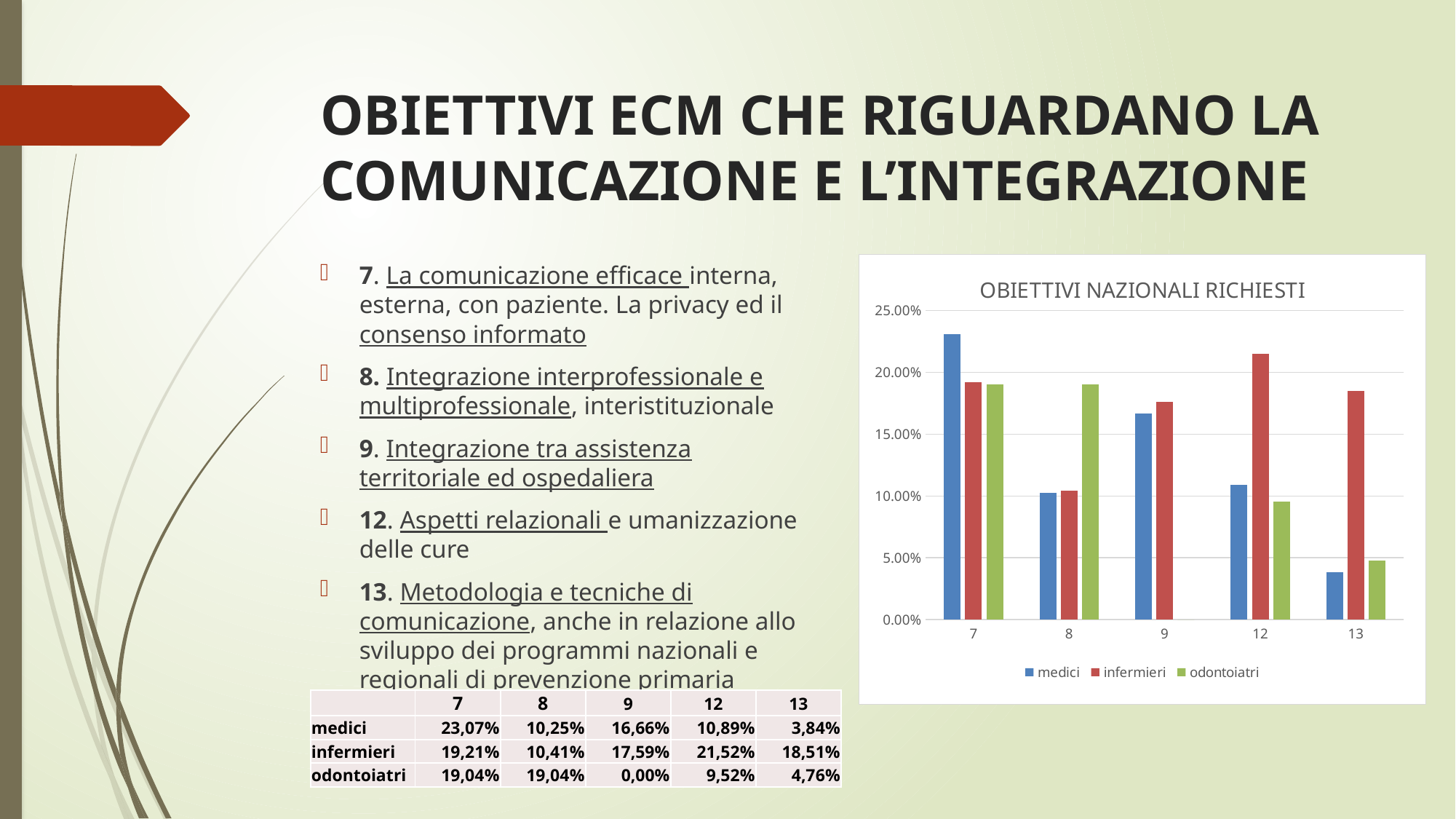
What is the value for medici in category 7? 23,07% What is the title of the chart? OBIETTIVI NAZIONALI RICHIESTI What kind of chart is shown on the slide? bar chart Is the value for medici in category 7 greater or less than 20.00%? greater In category 13, which series has the larger value, medici or infermieri? infermieri In which category is the value for odontoiatri lowest? 9 What is the difference between the infermieri and medici values in category 12? 10,63% How many categories are shown on the x axis of the chart? 5 What is the value for infermieri in category 12? 21,52% How many series does the chart legend list? 3 What is the value for odontoiatri in category 9? 0,00% In which category is the value for medici highest? 7